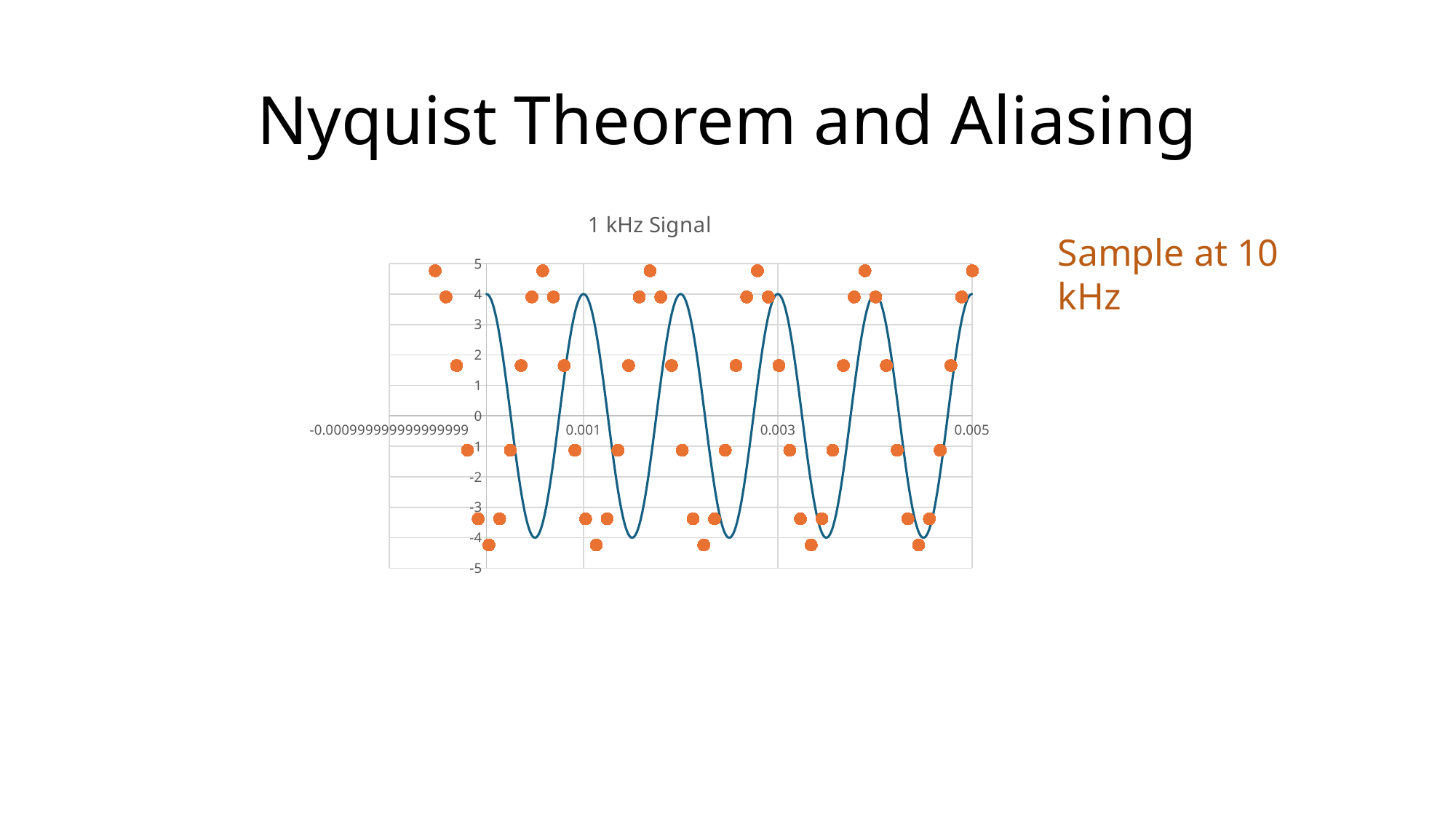
What is the highest value labelled on the vertical axis of the chart? 5 What is the difference between the peak and the trough of the blue line? 8 According to the text beside the chart, at what rate is the signal sampled? 10 kHz What is the peak value reached by the blue line in the chart? 4 What is the lowest value reached by the blue line in the chart? -4 What is the title of the chart? 1 kHz Signal How many troughs (minimum points) does the blue line have in the chart? 5 Are the highest orange dots greater or less than 4? greater What kind of chart is shown on the slide? line chart with scatter points Are the lowest orange dots greater or less than -4? less What is the rightmost value labelled on the horizontal axis? 0.005 What is the lowest value labelled on the vertical axis of the chart? -5